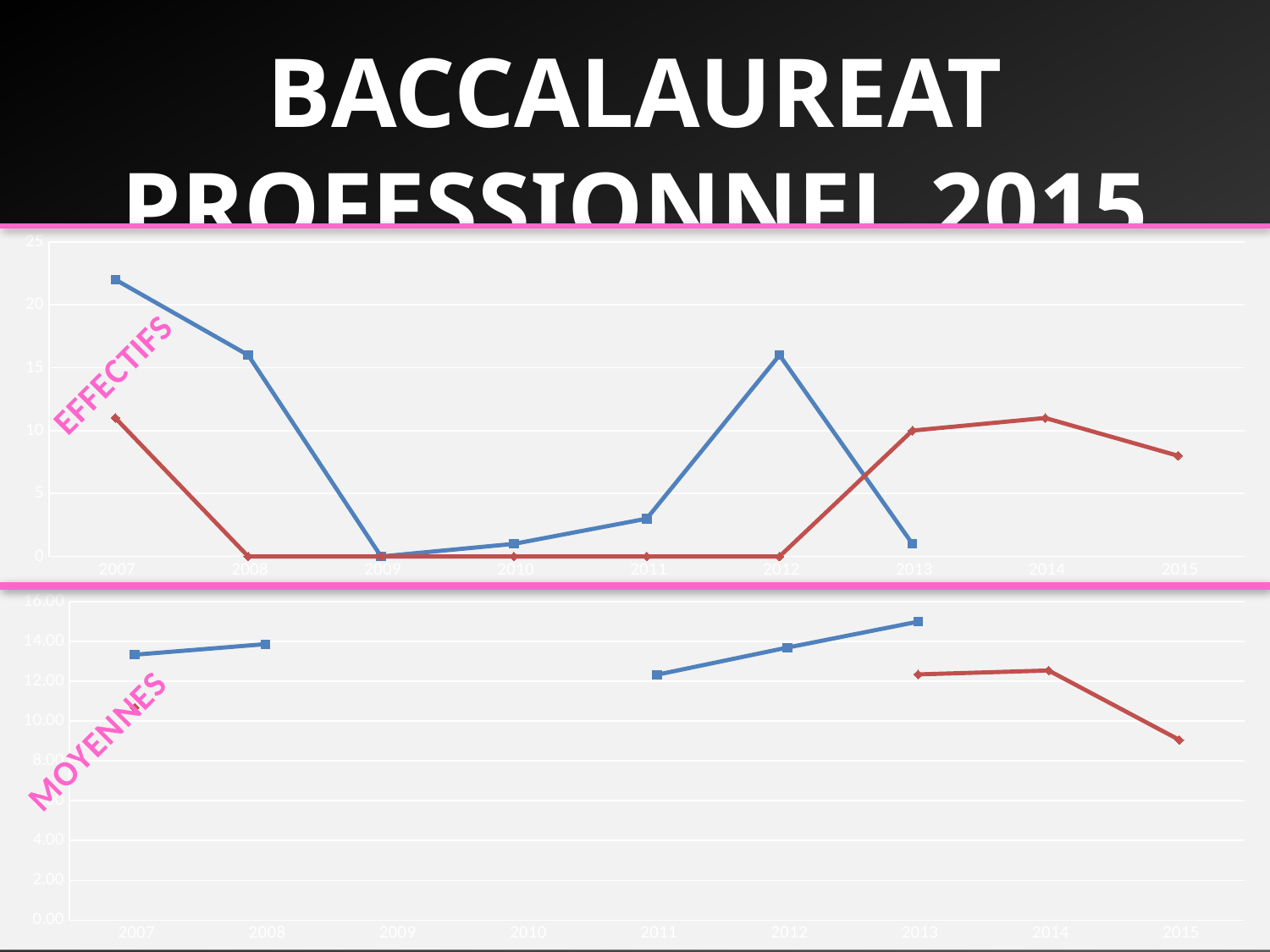
In the bottom chart (MOYENNES), is the value of the red line for 2015 greater or less than 10.00? less In the top chart (EFFECTIFS), which line has the larger value in 2012, the blue line or the red line? the blue line In the top chart (EFFECTIFS), what is the value of the blue line for 2009? 0 In the top chart (EFFECTIFS), is the value of the blue line for 2007 greater or less than 20? greater In the top chart (EFFECTIFS), what is the value of the red line for 2010? 0 In the top chart (EFFECTIFS), in which year does the blue line reach its highest value? 2007 In the bottom chart (MOYENNES), is the value of the blue line for 2013 greater or less than 14.00? greater In the bottom chart (MOYENNES), does the red line rise or fall from 2014 to 2015? fall In the top chart (EFFECTIFS), how many years are shown on the x axis? 9 What kind of chart is the top chart labelled EFFECTIFS? line chart What kind of chart is the bottom chart labelled MOYENNES? line chart